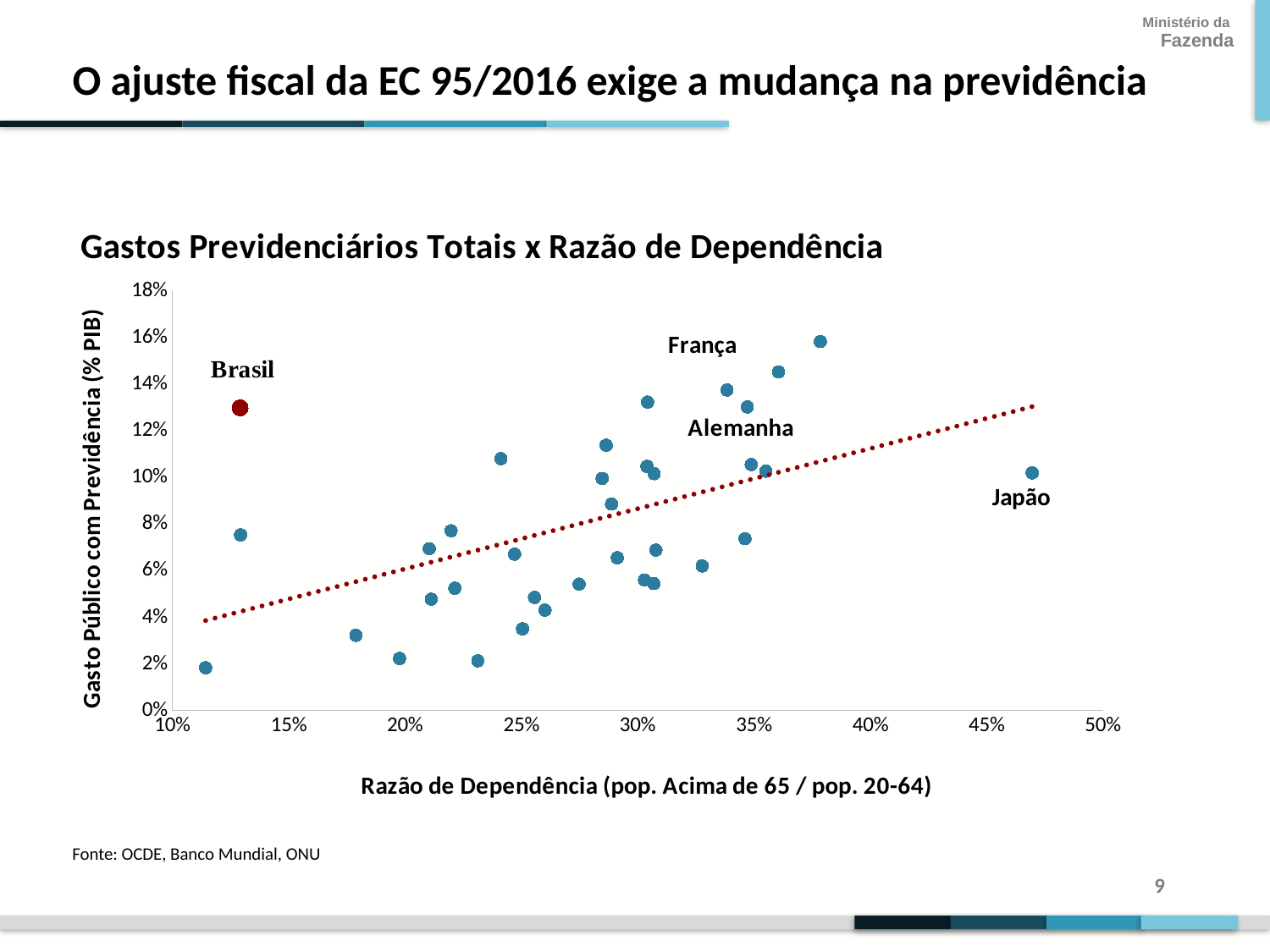
What is the title of the chart? Gastos Previdenciários Totais x Razão de Dependência Does the dotted trend line rise or fall as Razão de Dependência increases? rises What kind of chart is shown on the slide? scatter chart Is the Gasto Público com Previdência (% PIB) value for Japão greater or less than 12%? less What colour is the point for Brasil? red Is the Gasto Público com Previdência (% PIB) value for Brasil greater or less than 12%? greater Is the Razão de Dependência value for Japão greater or less than 45%? greater Which of the labelled countries has the highest Razão de Dependência? Japão Which has the larger Razão de Dependência, Brasil or Japão? Japão Which has the larger Gasto Público com Previdência (% PIB), Brasil or Japão? Brasil How many countries are labelled by name on the chart? 4